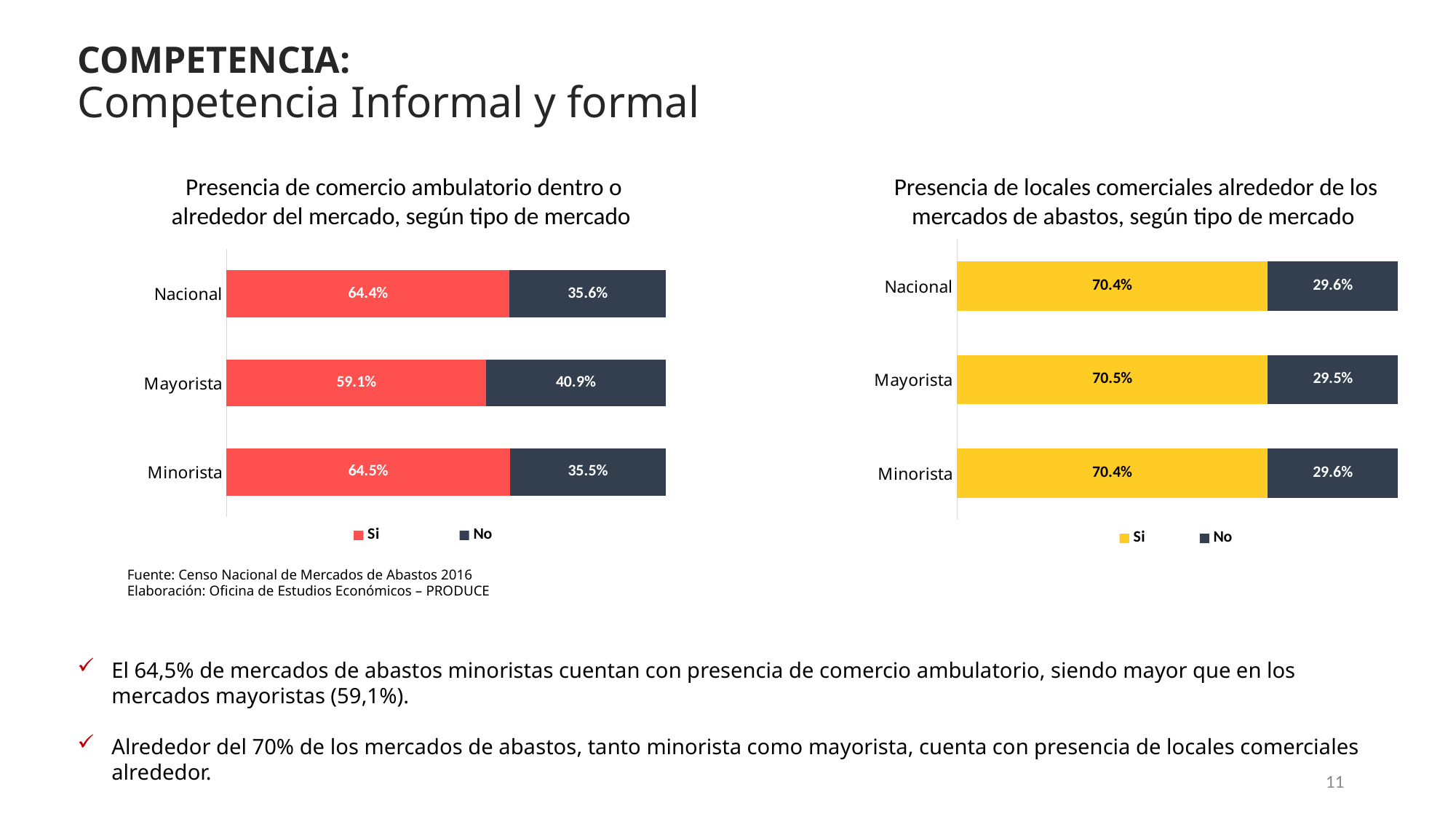
What type of chart is the right chart (Presencia de locales comerciales)? Stacked bar chart In the left chart (Presencia de comercio ambulatorio), what is the 'No' value for Mayorista? 40.9% In the left chart (Presencia de comercio ambulatorio), what is the difference between the 'Si' values for Minorista and Mayorista? 5.4% In the left chart (Presencia de comercio ambulatorio), which market type has the highest 'No' value? Mayorista How many market types are shown in the right chart (Presencia de locales comerciales)? 3 How many series does the legend of the left chart (Presencia de comercio ambulatorio) list? 2 In the right chart (Presencia de locales comerciales), what is the 'Si' value for Mayorista? 70.5% In the left chart (Presencia de comercio ambulatorio), which market type has the lowest 'Si' value? Mayorista In the right chart (Presencia de locales comerciales), what is the 'No' value for Nacional? 29.6% In the left chart (Presencia de comercio ambulatorio), is the 'Si' value larger for Minorista or for Mayorista? Minorista In the left chart (Presencia de comercio ambulatorio), what is the 'Si' value for Minorista? 64.5% In the right chart (Presencia de locales comerciales), what colour represents the 'Si' series? Yellow